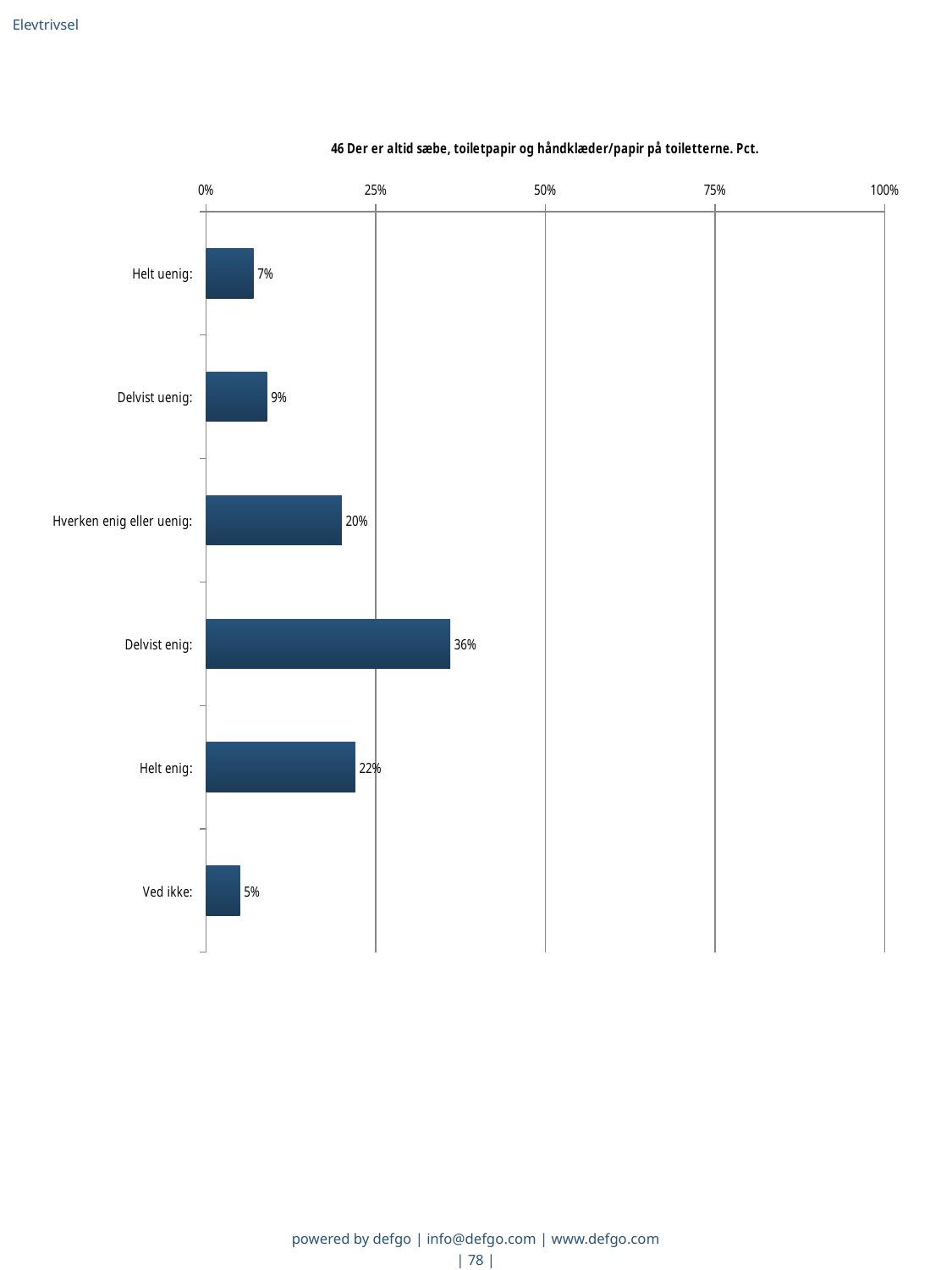
What kind of chart is shown on the slide? Bar chart What is the value for "Ved ikke"? 5% Which is larger, the value for "Hverken enig eller uenig" or the value for "Helt enig"? Helt enig What is the value for "Helt uenig"? 7% What is the difference between the values for "Delvist enig" and "Helt enig"? 14% Which category has the highest value? Delvist enig Is the value for "Delvist enig" greater or less than 25%? greater How many categories are shown in the chart? 6 What is the title of the chart? 46 Der er altid sæbe, toiletpapir og håndklæder/papir på toiletterne. Pct. What is the combined value of "Delvist enig" and "Helt enig"? 58% Which category has the lowest value? Ved ikke What is the value for "Delvist enig"? 36%